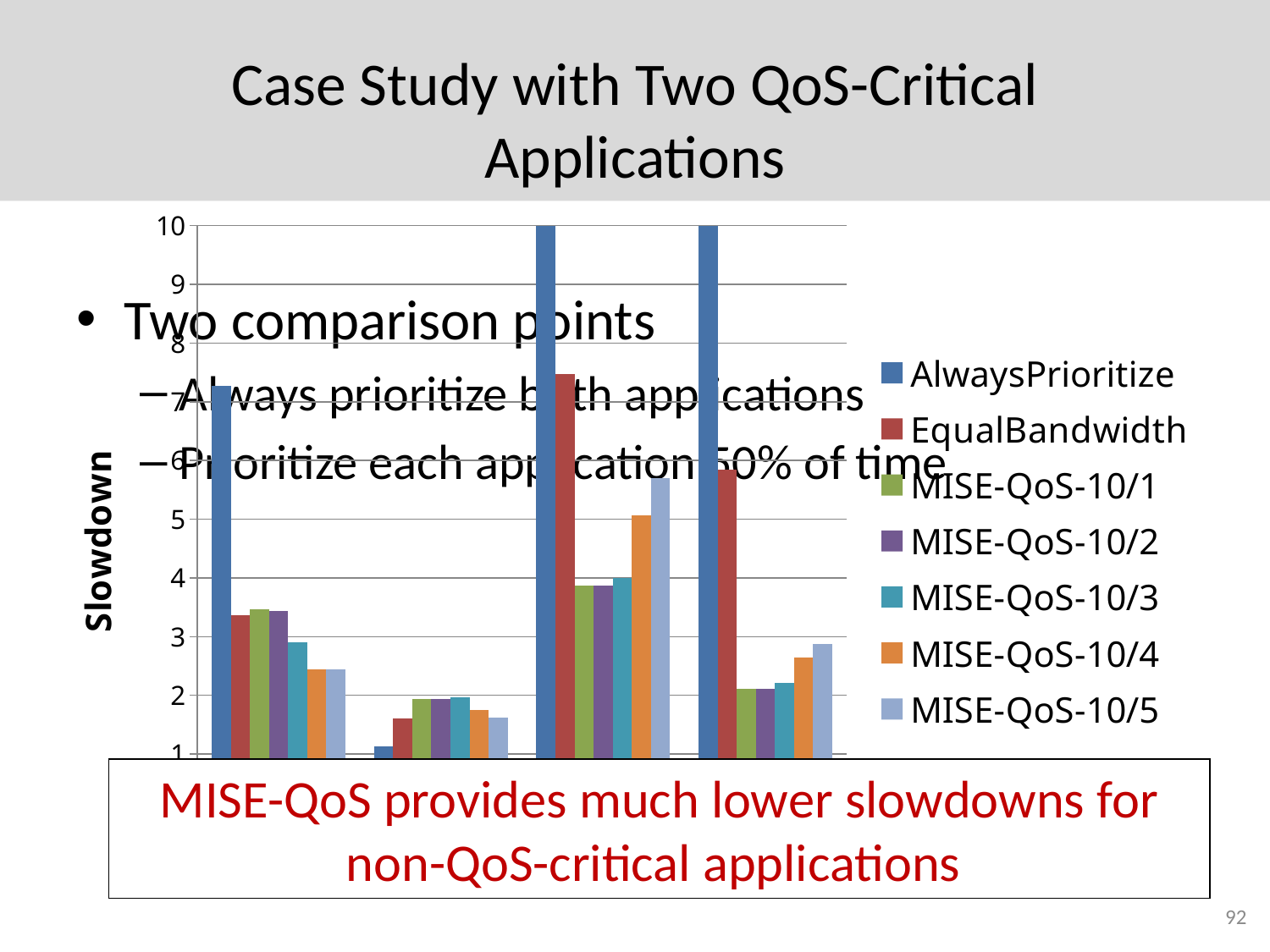
In the leftmost group of bars, is the value for AlwaysPrioritize greater or less than 6? greater What kind of chart is shown on the slide? bar chart What is the title of the chart's vertical axis? Slowdown In the third group of bars from the left, which is larger: MISE-QoS-10/5 or MISE-QoS-10/1? MISE-QoS-10/5 How many series does the chart's legend list? 7 What is the first entry in the chart's legend? AlwaysPrioritize In the leftmost group of bars, is the value for MISE-QoS-10/5 greater or less than 3? less How many groups of bars are plotted in the chart? 4 In the third group of bars from the left, is the value for EqualBandwidth greater or less than 6? greater In the rightmost group of bars, which series has the highest value? AlwaysPrioritize In the leftmost group of bars, which is larger: AlwaysPrioritize or EqualBandwidth? AlwaysPrioritize